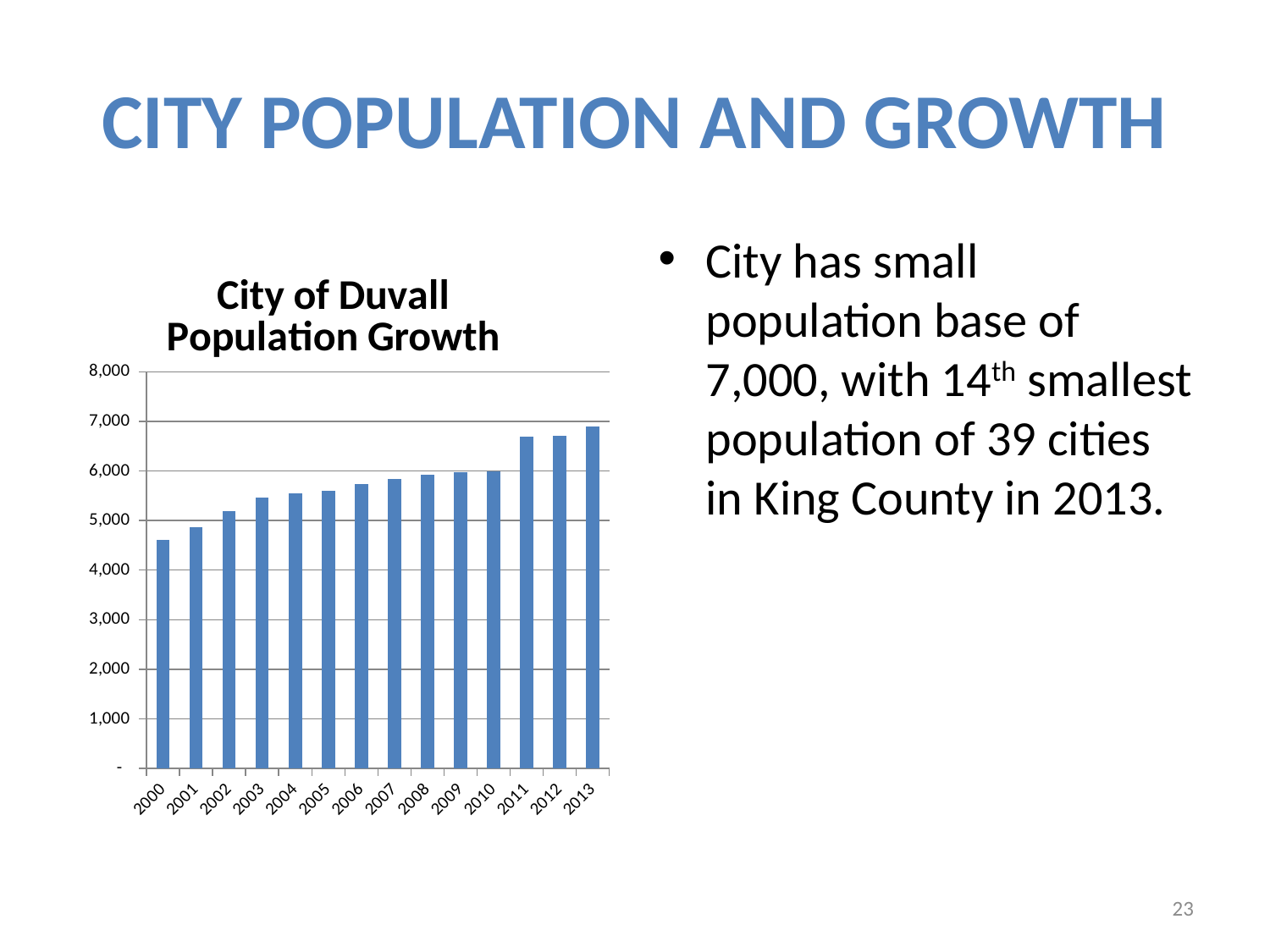
What is the title of the chart? City of Duvall Population Growth Is the value for 2000 greater or less than 5,000? less What is the first year shown on the x axis? 2000 Which is larger, the value for 2002 or the value for 2011? 2011 What kind of chart is shown on the slide? bar chart Is the value for 2005 greater or less than 6,000? less Is the value for 2011 greater or less than 7,000? less How many years are plotted on the chart? 14 Do the population values generally rise or fall from 2000 to 2013? rise Which year has the highest population on the chart? 2013 Which year has the lowest population on the chart? 2000